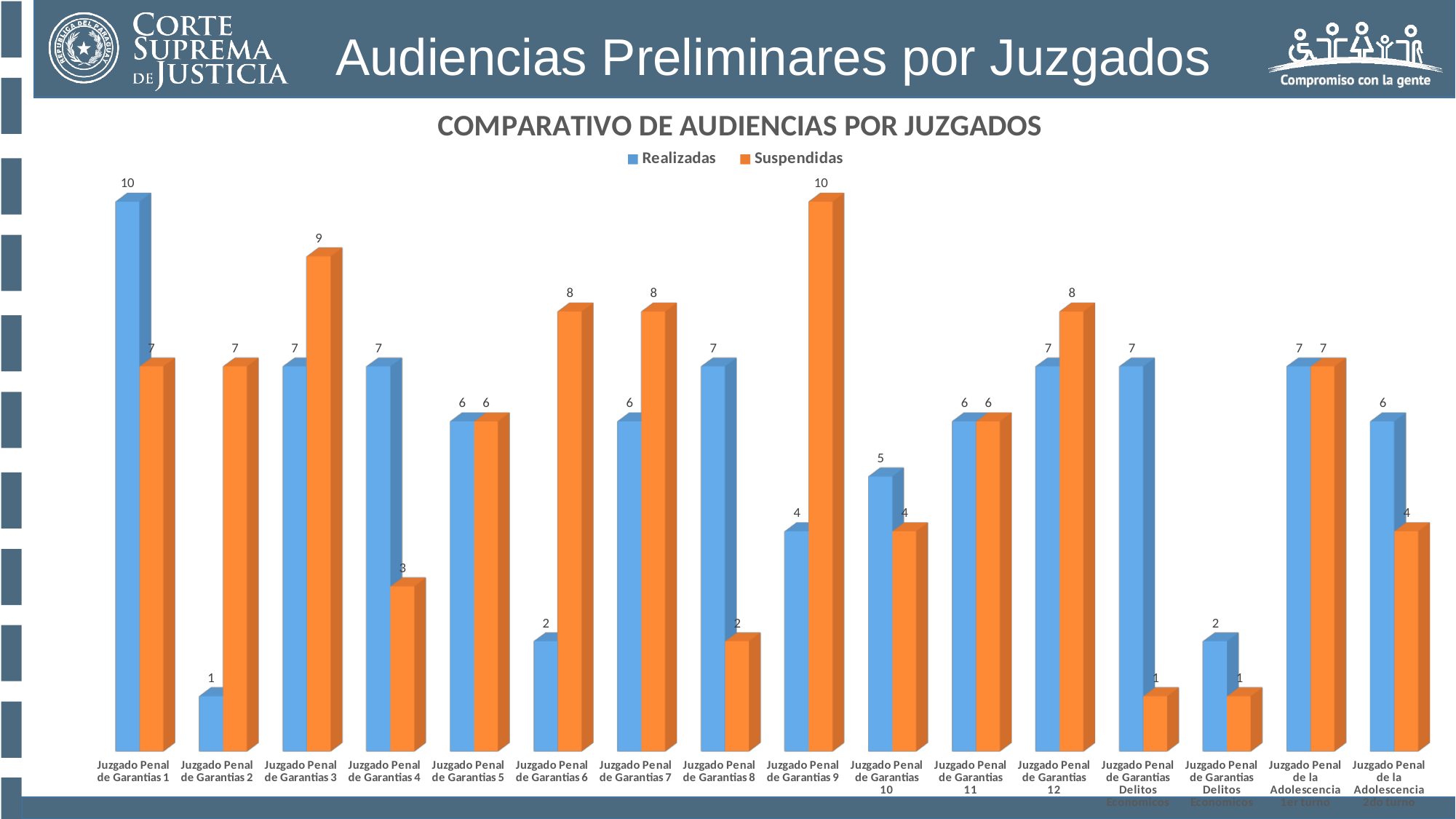
What is the difference between Suspendidas and Realizadas for Juzgado Penal de Garantias 9? 6 What is the Suspendidas value for Juzgado Penal de Garantias 3? 9 How many series does the legend list? 2 For Juzgado Penal de Garantias 4, which is larger, Realizadas or Suspendidas? Realizadas What is the difference between Realizadas and Suspendidas for Juzgado Penal de Garantias 8? 5 What is the Realizadas value for Juzgado Penal de Garantias 6? 2 What is the Realizadas value for Juzgado Penal de Garantias 1? 10 How many juzgados (categories) are shown on the x axis? 16 What type of chart is shown on the slide? bar chart Which juzgado has the highest Suspendidas value? Juzgado Penal de Garantias 9 What is the title of the chart? COMPARATIVO DE AUDIENCIAS POR JUZGADOS Which juzgado has the lowest Realizadas value? Juzgado Penal de Garantias 2